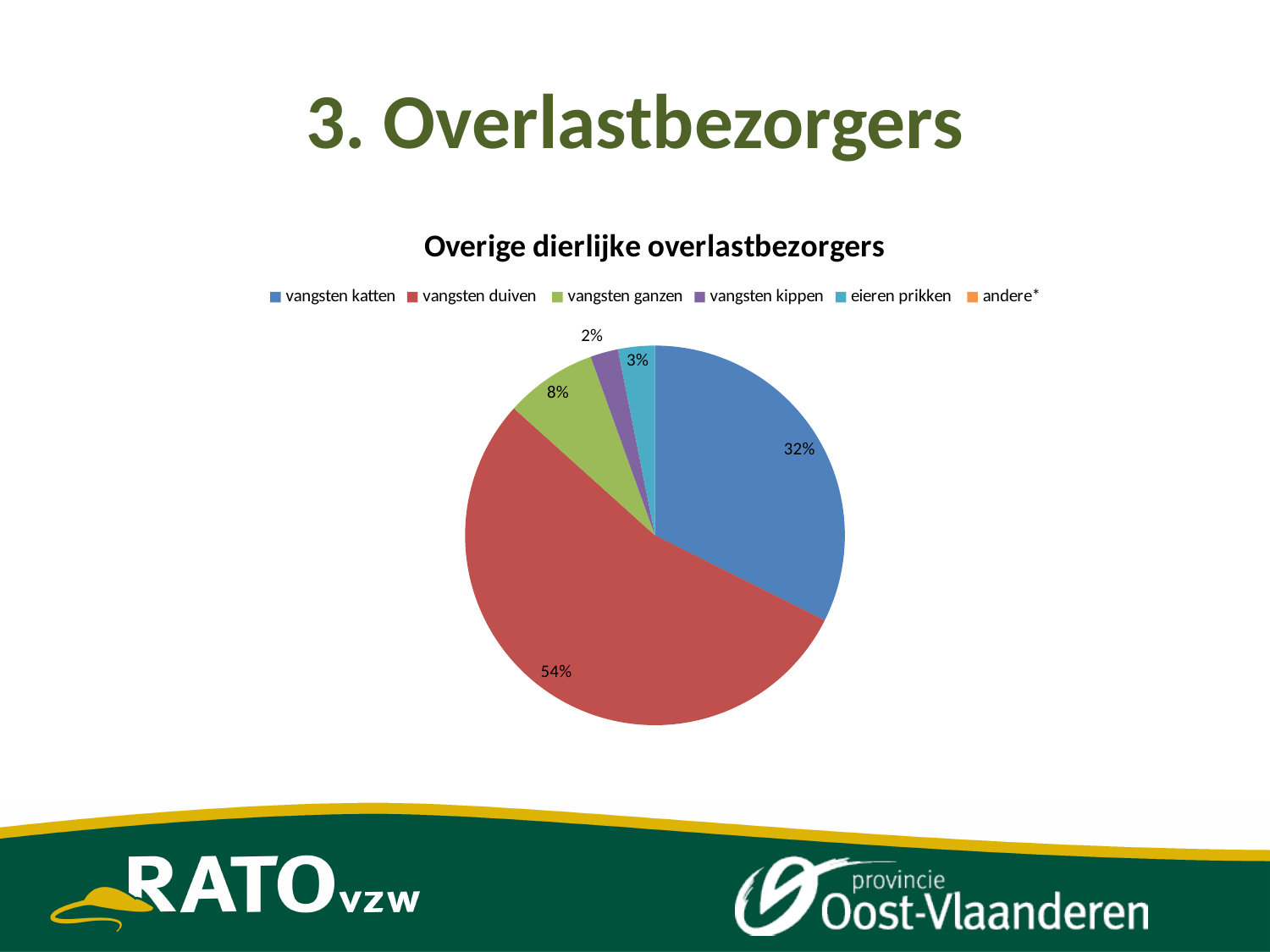
What share of the pie is 'vangsten katten'? 32% What is the title of the chart? Overige dierlijke overlastbezorgers What colour is the slice for 'vangsten katten'? blue What type of chart is shown on the slide? pie chart Which category has the largest slice of the pie? vangsten duiven How many entries does the chart's legend list? 6 What percentage is shown for 'eieren prikken'? 3% What percentage is shown for 'vangsten ganzen'? 8% What share of the pie is 'vangsten duiven'? 54% What percentage is shown for 'vangsten kippen'? 2% Which is larger, the slice for 'vangsten ganzen' or the slice for 'eieren prikken'? vangsten ganzen What is the difference in percentage points between 'vangsten duiven' and 'vangsten katten'? 22